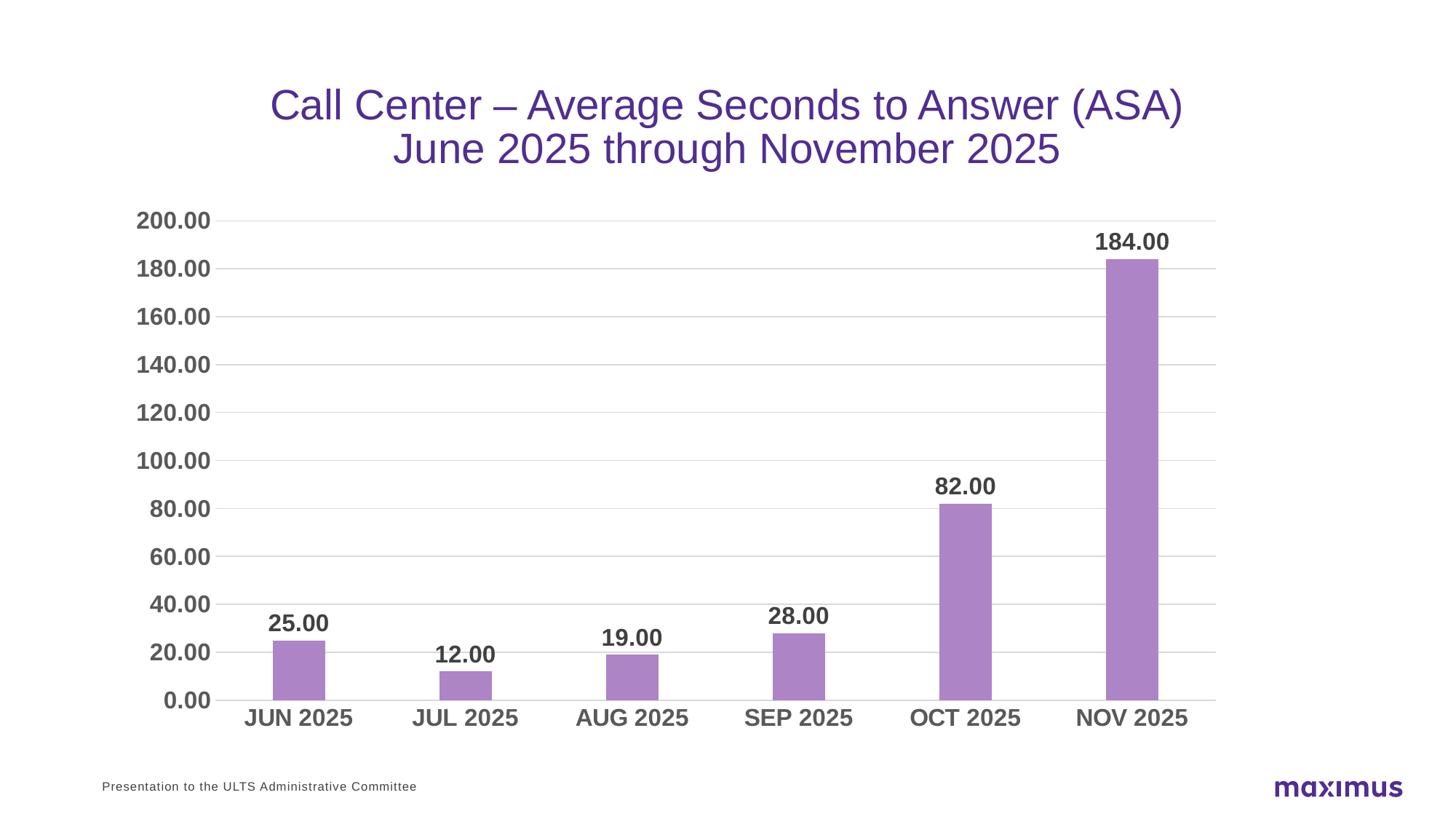
Is the value for OCT 2025 greater or less than 100.00? less What is the difference between the values for JUN 2025 and AUG 2025? 6.00 Which month has the lowest average seconds to answer? JUL 2025 What kind of chart is shown on the slide? Bar chart What is the value for JUL 2025? 12.00 What is the value for SEP 2025? 28.00 How many months are shown on the x axis? 6 What is the title of the chart? Call Center – Average Seconds to Answer (ASA) June 2025 through November 2025 What is the difference between the values for NOV 2025 and OCT 2025? 102.00 Which month has the highest average seconds to answer? NOV 2025 Which is larger, the value for SEP 2025 or the value for JUN 2025? SEP 2025 What is the value for NOV 2025? 184.00